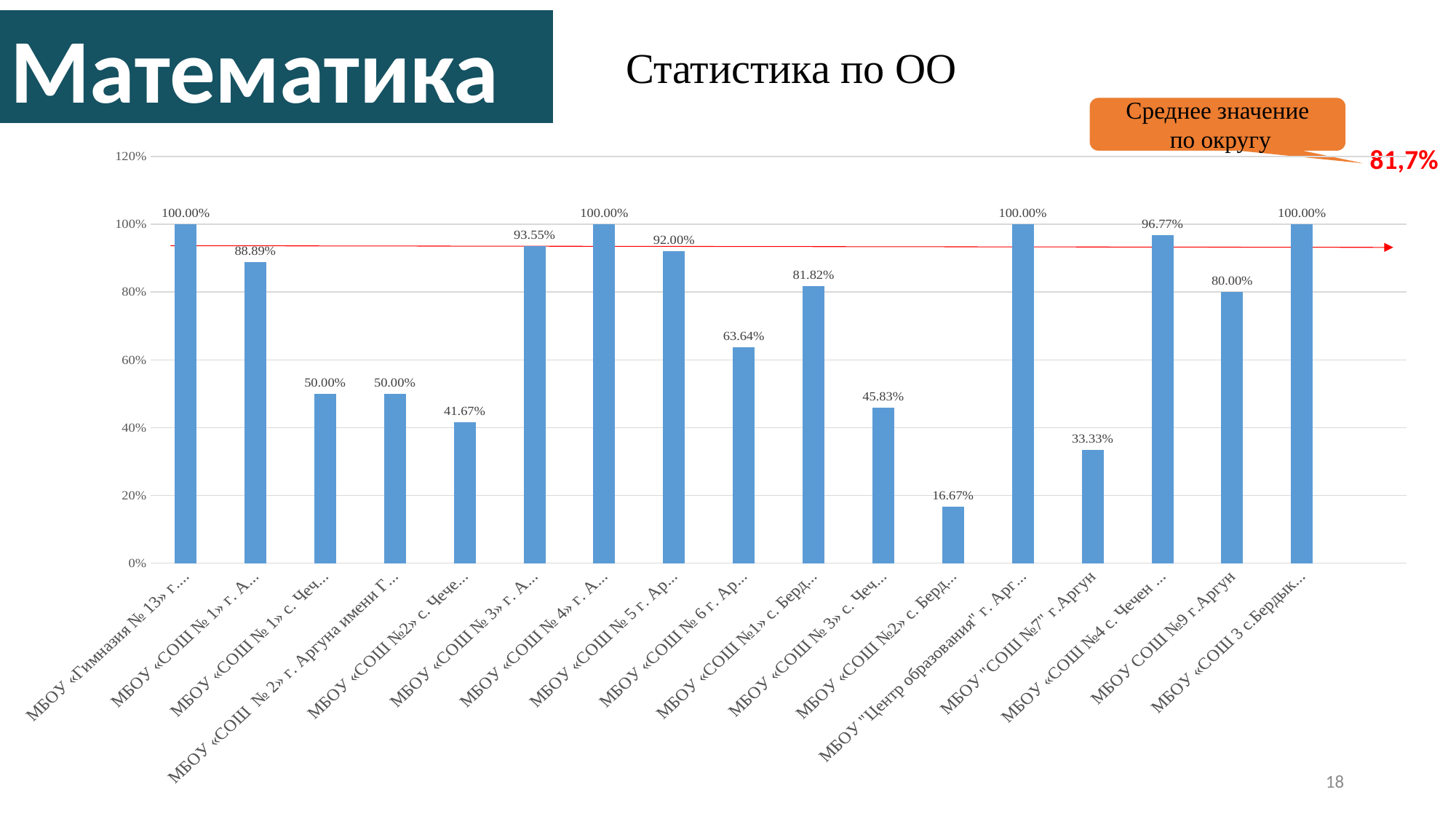
What is the average value for the district (Среднее значение по округу) shown on the slide? 81,7% What is the value for МБОУ "СОШ №7" г.Аргун? 33.33% What type of chart is shown on the slide? bar chart What is the lowest value shown in the chart? 16.67% What is the highest value shown in the chart? 100.00% How many bars (categories) are plotted in the chart? 17 Which has the larger value: МБОУ СОШ №9 г.Аргун or МБОУ "СОШ №7" г.Аргун? МБОУ СОШ №9 г.Аргун What is the title of the chart? Статистика по ОО How many bars reach 100.00%? 4 What is the difference between the values for МБОУ СОШ №9 г.Аргун and МБОУ "СОШ №7" г.Аргун? 46.67% What is the value for МБОУ СОШ №9 г.Аргун? 80.00% Is the value for МБОУ "СОШ №7" г.Аргун greater or less than 40%? less